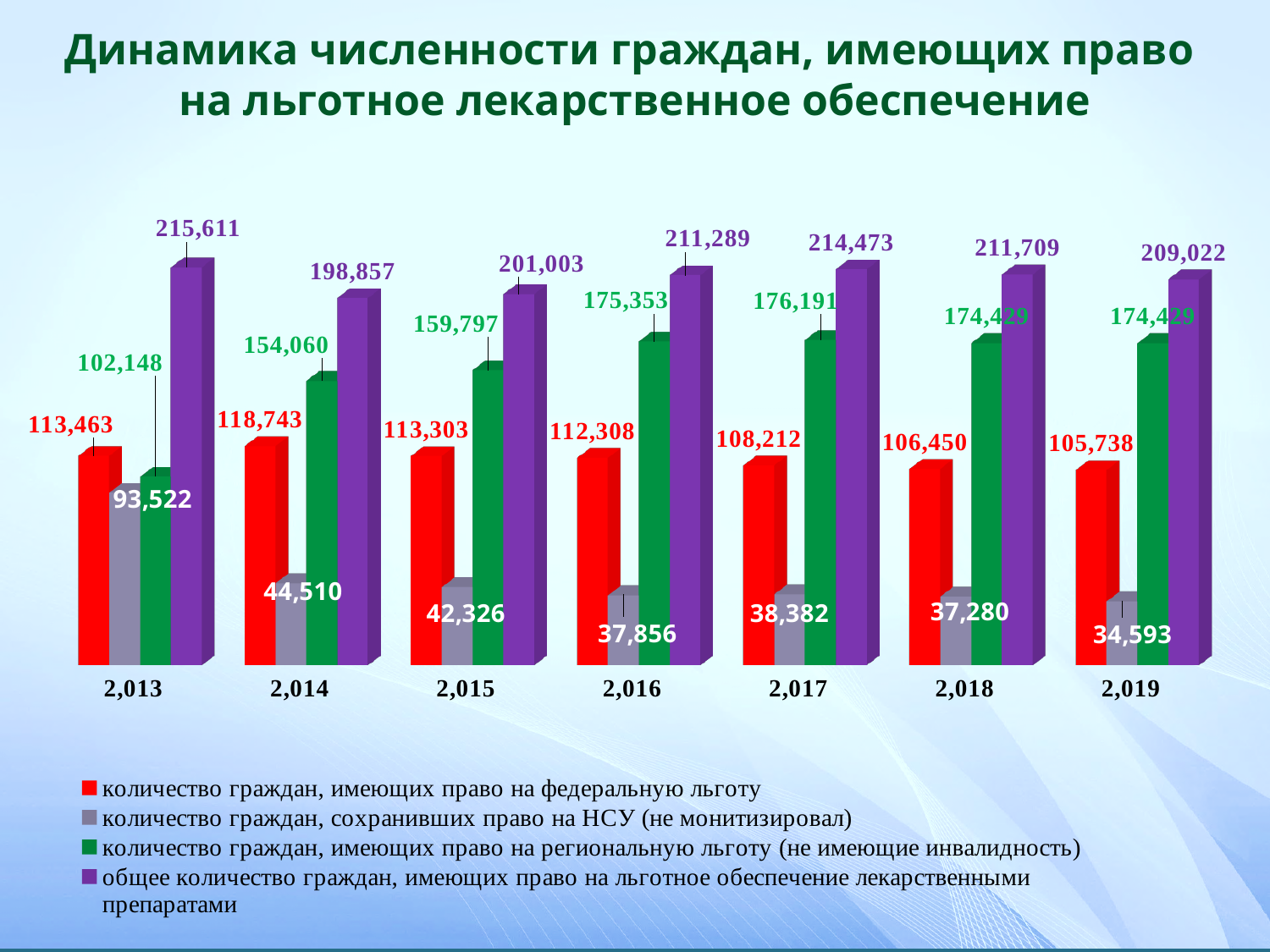
Does the red series (количество граждан, имеющих право на федеральную льготу) rise or fall from 2014 to 2019? Fall In which year is the gray series (количество граждан, сохранивших право на НСУ) lowest? 2019 What is the difference between the purple series values for 2013 and 2019? 6,589 What is the value of the gray series (количество граждан, сохранивших право на НСУ) for 2016? 37,856 How many years (categories) are shown on the x axis of the chart? 7 What is the value of the green series (количество граждан, имеющих право на региональную льготу) for 2015? 159,797 What type of chart is shown on the slide? Bar chart Which is larger: the red series value for 2014 or the red series value for 2017? 2014 (118,743) In which year is the purple series (общее количество граждан) highest? 2013 How many series does the legend list? 4 What is the value of the purple series (общее количество граждан, имеющих право на льготное обеспечение лекарственными препаратами) for 2013? 215,611 What is the value of the red series (количество граждан, имеющих право на федеральную льготу) for 2019? 105,738